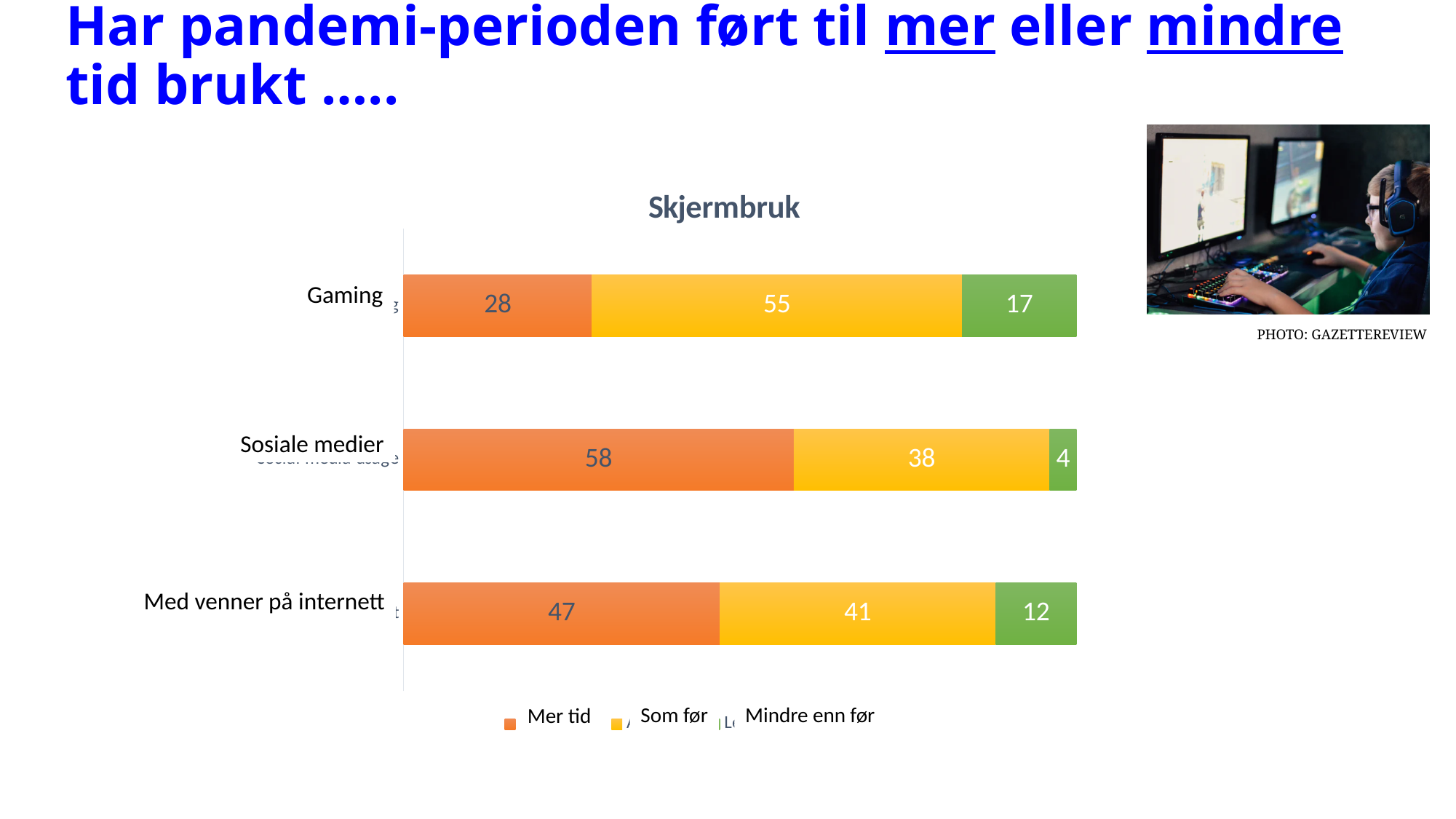
What is the value of "Mer tid" for Gaming? 28 Which category has the highest "Mer tid" value? Sosiale medier What is the value of "Som før" for Sosiale medier? 38 What kind of chart is shown on the slide? Stacked bar chart What is the difference between the "Som før" values for Gaming and Med venner på internett? 14 How many series does the legend list? 3 How many categories are shown in the chart? 3 Which category has the lowest "Mindre enn før" value? Sosiale medier What is the title of the chart? Skjermbruk What is the value of "Mindre enn før" for Med venner på internett? 12 What is the total of the stacked bar for Sosiale medier? 100 Which is larger: "Mer tid" for Gaming or "Mer tid" for Med venner på internett? Med venner på internett